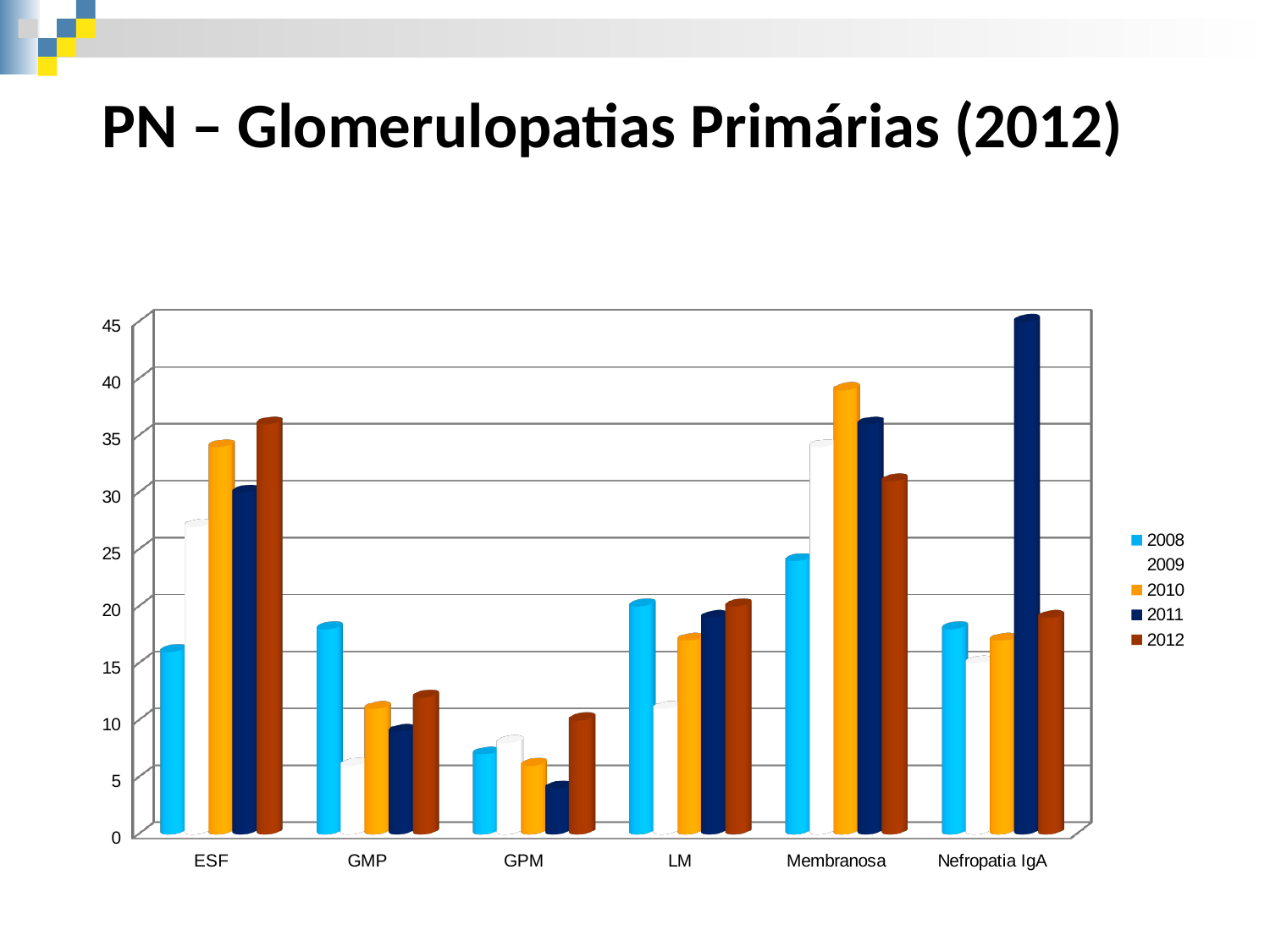
How many series does the legend list? 5 Which is larger, the 2008 value for GMP or the 2008 value for GPM? GMP Which is larger, the 2012 value for ESF or the 2012 value for Membranosa? ESF Which category has the lowest value for the 2011 series? GPM Is the 2008 value for ESF greater or less than 20? less What is the title of the slide containing the chart? PN – Glomerulopatias Primárias (2012) Which category has the highest value for the 2011 series? Nefropatia IgA How many categories are shown on the x axis of the chart? 6 Is the 2011 value for Nefropatia IgA greater or less than 40? greater Is the 2010 value for Membranosa greater or less than 35? greater Which category has the lowest value for the 2008 series? GPM What kind of chart is shown on the slide? bar chart